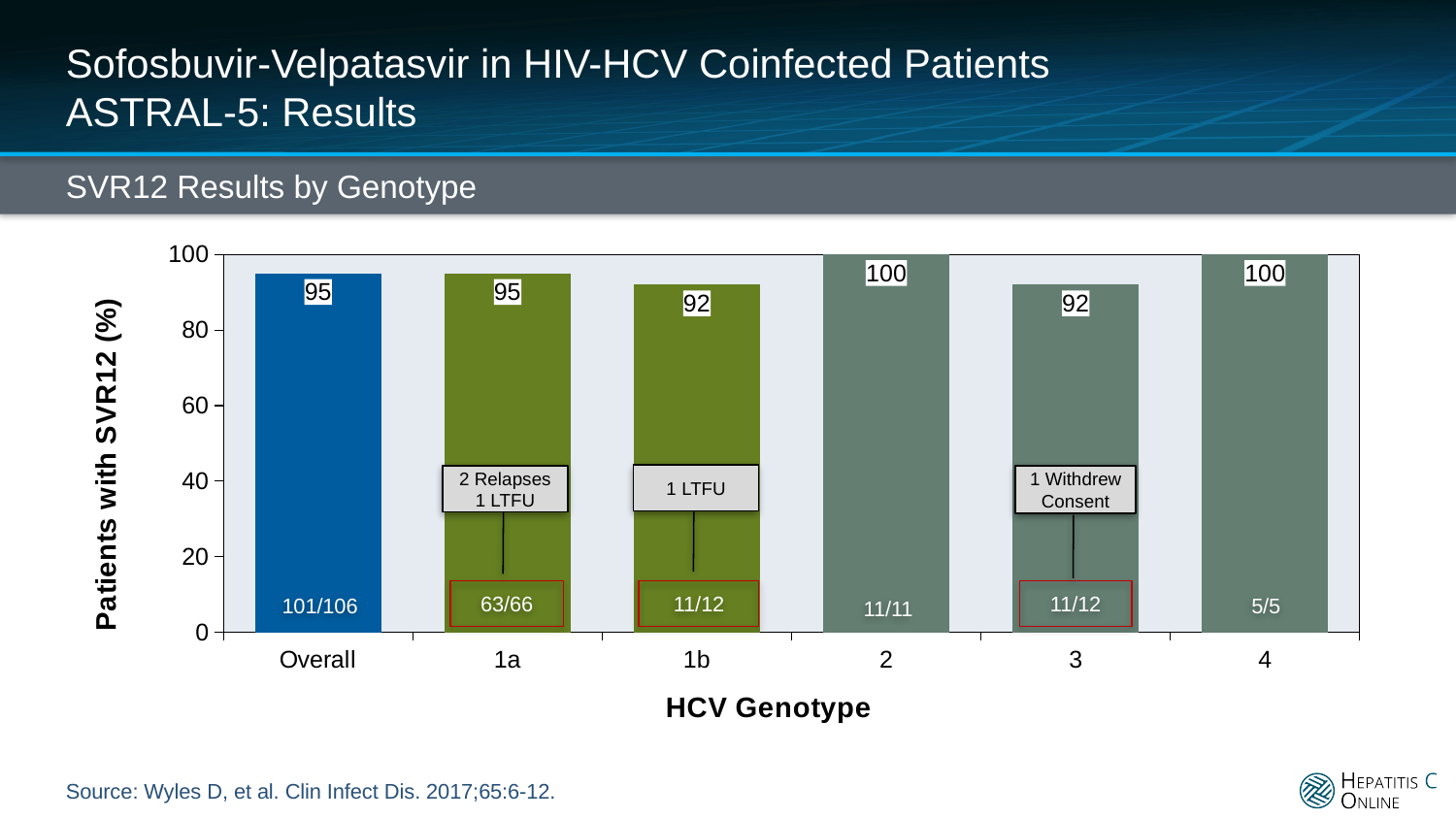
Which genotypes have the highest SVR12 rate? 2 and 4 What is the SVR12 rate for the Overall group? 95 What is the difference in SVR12 rate between genotype 2 and genotype 1b? 8 What kind of chart is shown on the slide? Bar chart Is the SVR12 rate for genotype 1a greater or less than 80? greater What is the SVR12 rate for genotype 1b? 92 How many patients achieved SVR12 in the Overall group, as shown by the fraction label? 101/106 What annotation is shown on the genotype 3 bar? 1 Withdrew Consent What is the SVR12 rate for genotype 3? 92 How many categories are shown on the x axis? 6 What is the label on the y axis? Patients with SVR12 (%) What fraction label is shown for genotype 1a? 63/66